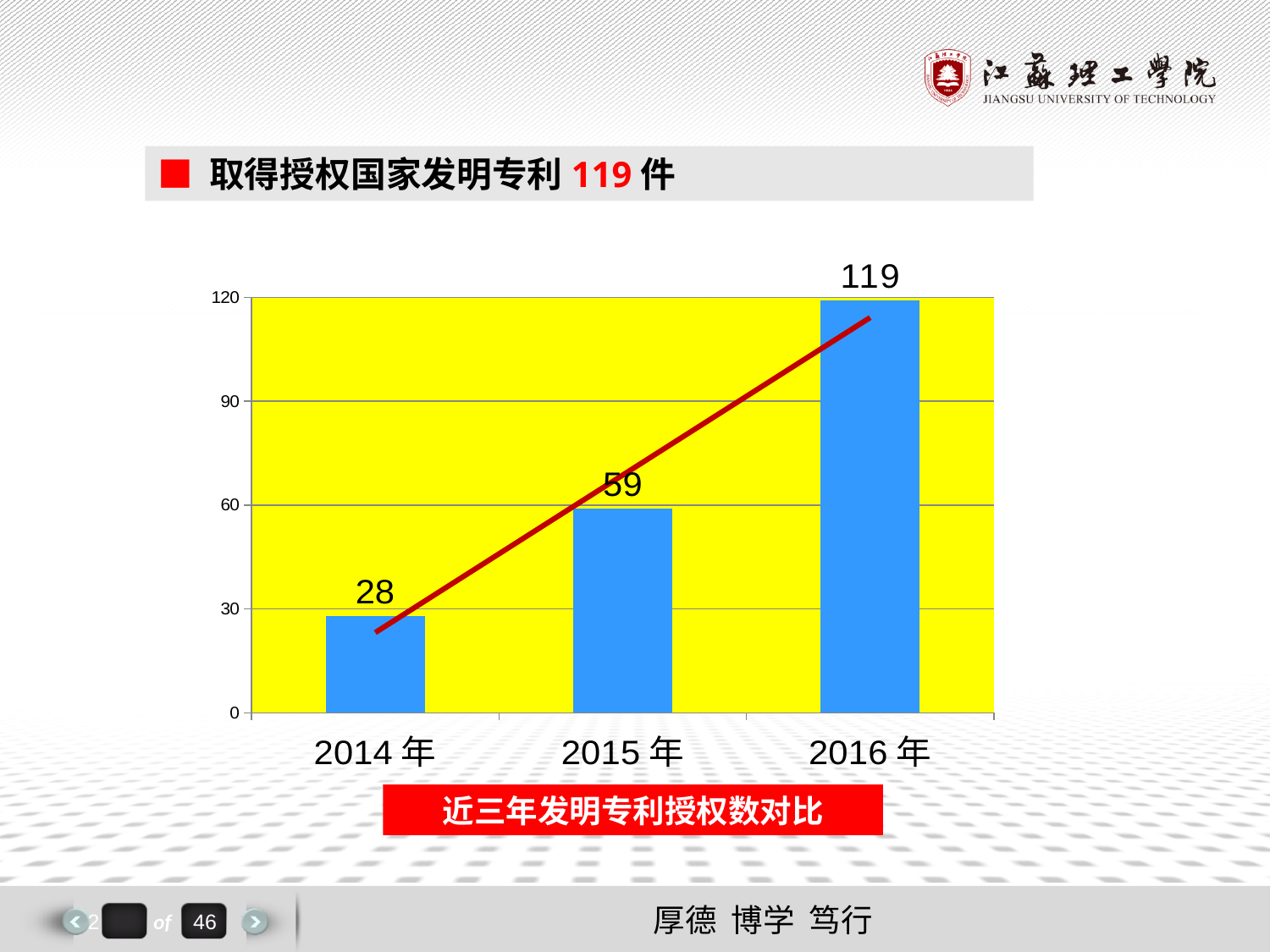
How many years are shown on the x axis? 3 Which year has the lowest value? 2014年 Which year has the highest value? 2016年 What is the value for 2016年? 119 What is the value for 2014年? 28 What is the value for 2015年? 59 What is the difference between the values for 2015年 and 2014年? 31 Is the value for 2016年 greater or less than 90? greater What is the difference between the values for 2016年 and 2015年? 60 Which is larger, the value for 2015年 or the value for 2014年? 2015年 Do the values rise or fall from 2014年 to 2016年? rise What kind of chart is shown on the slide? bar chart